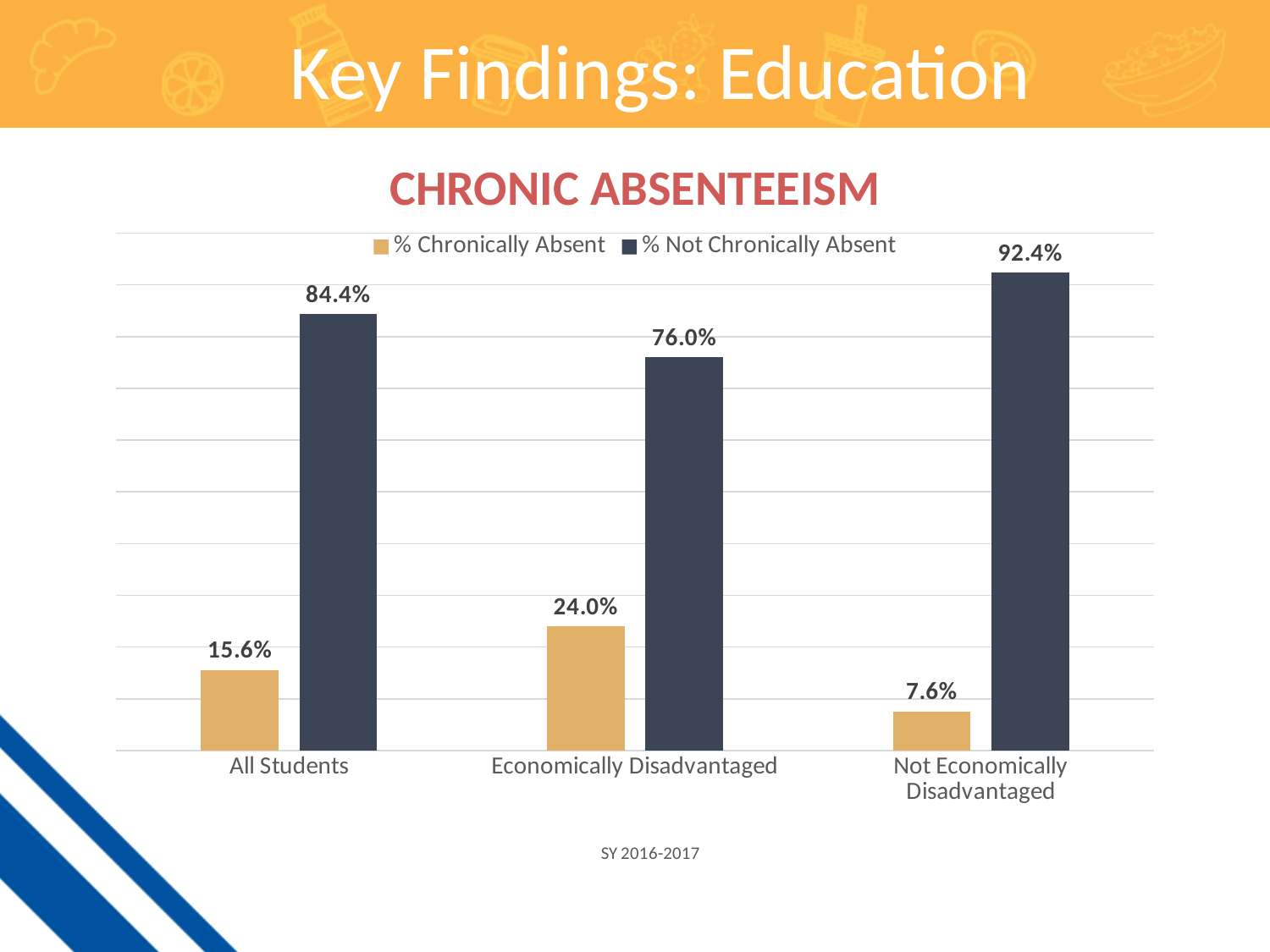
What is the % Chronically Absent value for Economically Disadvantaged students? 24.0% What is the difference between the % Chronically Absent values for Economically Disadvantaged and Not Economically Disadvantaged students? 16.4% Which is larger: the % Not Chronically Absent value for All Students or for Not Economically Disadvantaged students? Not Economically Disadvantaged What is the title of the chart? CHRONIC ABSENTEEISM What kind of chart is shown on the slide? Bar chart Which category has the highest % Chronically Absent value? Economically Disadvantaged How many categories are shown on the x axis? 3 What is the % Not Chronically Absent value for All Students? 84.4% Which category has the lowest % Not Chronically Absent value? Economically Disadvantaged How many series does the legend list? 2 What school year is noted below the chart? SY 2016-2017 What is the % Chronically Absent value for Not Economically Disadvantaged students? 7.6%